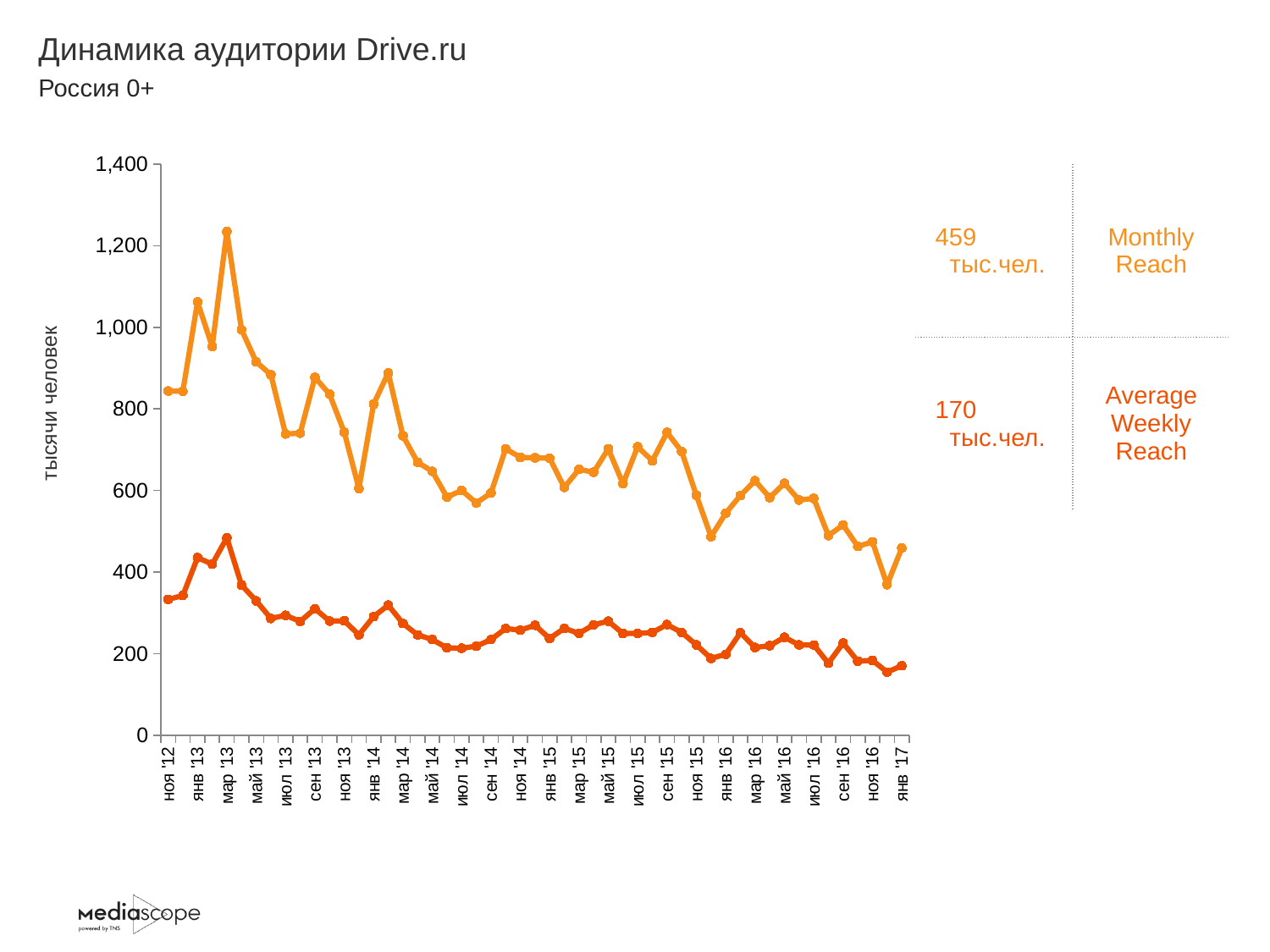
Which series is higher at мар '13, Monthly Reach or Average Weekly Reach? Monthly Reach In which month does the Monthly Reach line reach its highest point? мар '13 Does the Monthly Reach line overall rise or fall from ноя '12 to янв '17? fall How many series are plotted on the chart? 2 What Average Weekly Reach value is shown on the slide? 170 тыс.чел. Is the Average Weekly Reach value for янв '17 greater or less than 200? less Is the Monthly Reach value for ноя '16 greater or less than 400? greater What Monthly Reach value is shown on the slide? 459 тыс.чел. Is the Monthly Reach value for мар '13 greater or less than 1,200? greater What is the label on the vertical axis of the chart? тысячи человек What kind of chart is shown on the slide? line chart